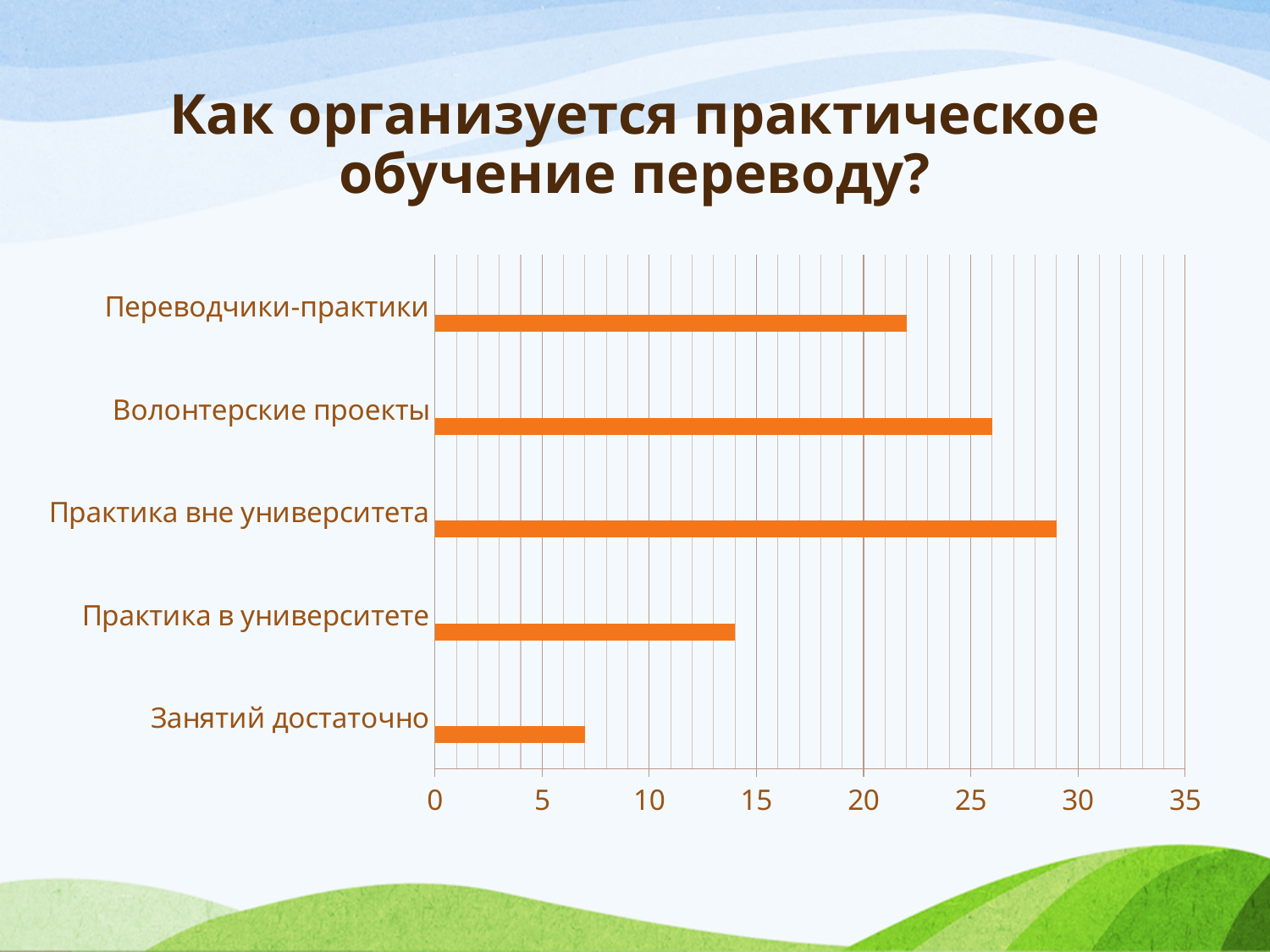
Is the value for Переводчики-практики greater or less than 20? greater Which is larger, the value for Практика в университете or the value for Занятий достаточно? Практика в университете What kind of chart is shown on the slide? bar chart Is the value for Практика в университете greater or less than 15? less Is the value for Занятий достаточно greater or less than 10? less How many categories does the chart show? 5 Which category has the lowest value? Занятий достаточно Which is larger, the value for Волонтерские проекты or the value for Переводчики-практики? Волонтерские проекты What is the title of the slide containing the chart? Как организуется практическое обучение переводу? Which category has the highest value? Практика вне университета